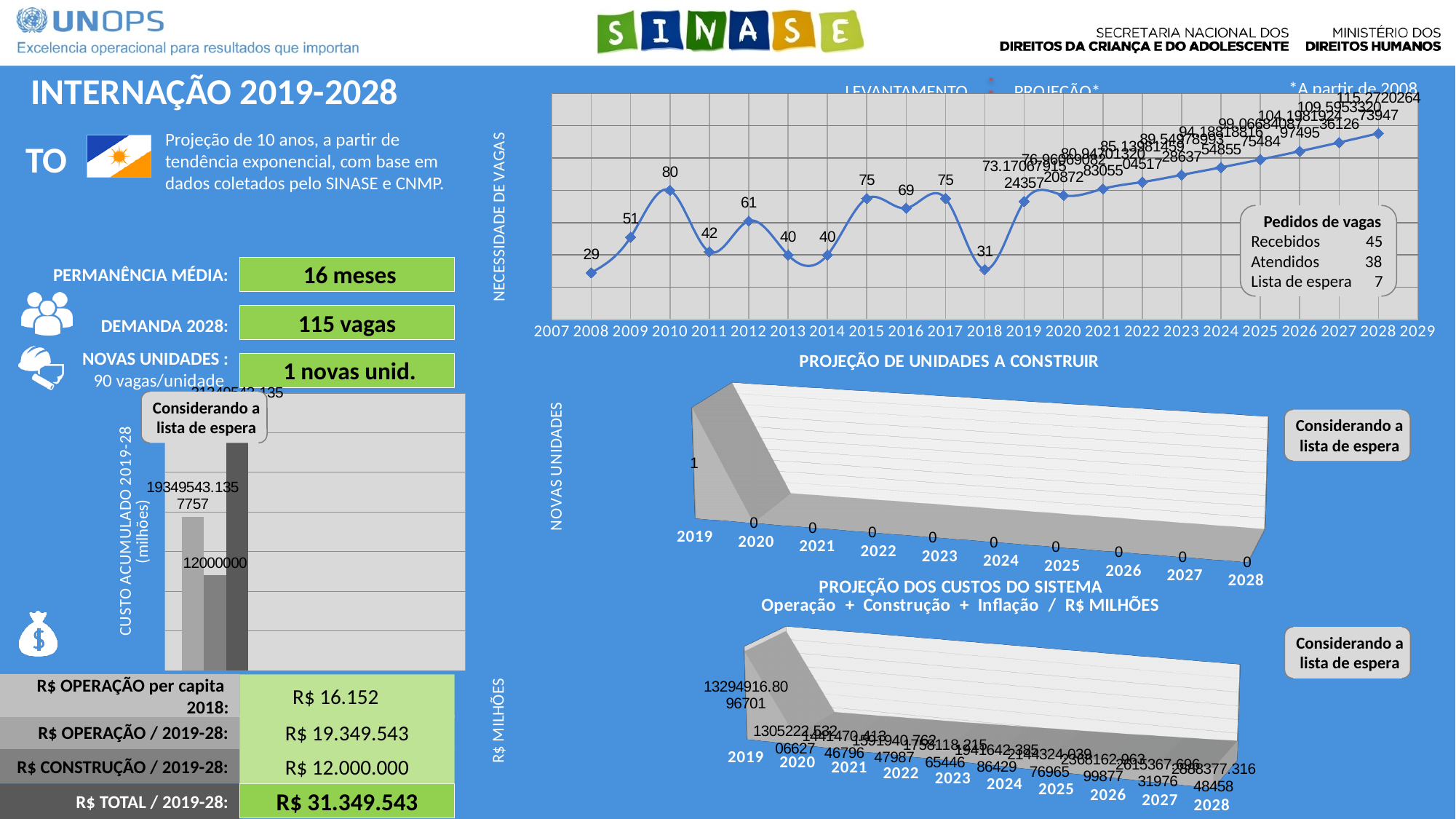
In the NECESSIDADE DE VAGAS line chart, which is larger, the value for 2015 or the value for 2016? 2015 What kind of chart is the PROJEÇÃO DE UNIDADES A CONSTRUIR chart? area chart In the NECESSIDADE DE VAGAS line chart, what is the difference between the values for 2010 and 2008? 51 In the NECESSIDADE DE VAGAS line chart, what is the value for 2010? 80 In the NECESSIDADE DE VAGAS line chart, do the values rise or fall from 2019 to 2028? rise In the NECESSIDADE DE VAGAS line chart, which year between 2008 and 2018 has the highest value? 2010 How many years are shown on the x axis of the PROJEÇÃO DE UNIDADES A CONSTRUIR chart? 10 In the NECESSIDADE DE VAGAS line chart, what is the value for 2018? 31 In the PROJEÇÃO DE UNIDADES A CONSTRUIR chart, what is the value for 2019? 1 In the NECESSIDADE DE VAGAS line chart, which year between 2008 and 2018 has the lowest value? 2008 In the NECESSIDADE DE VAGAS line chart, what is the value for 2008? 29